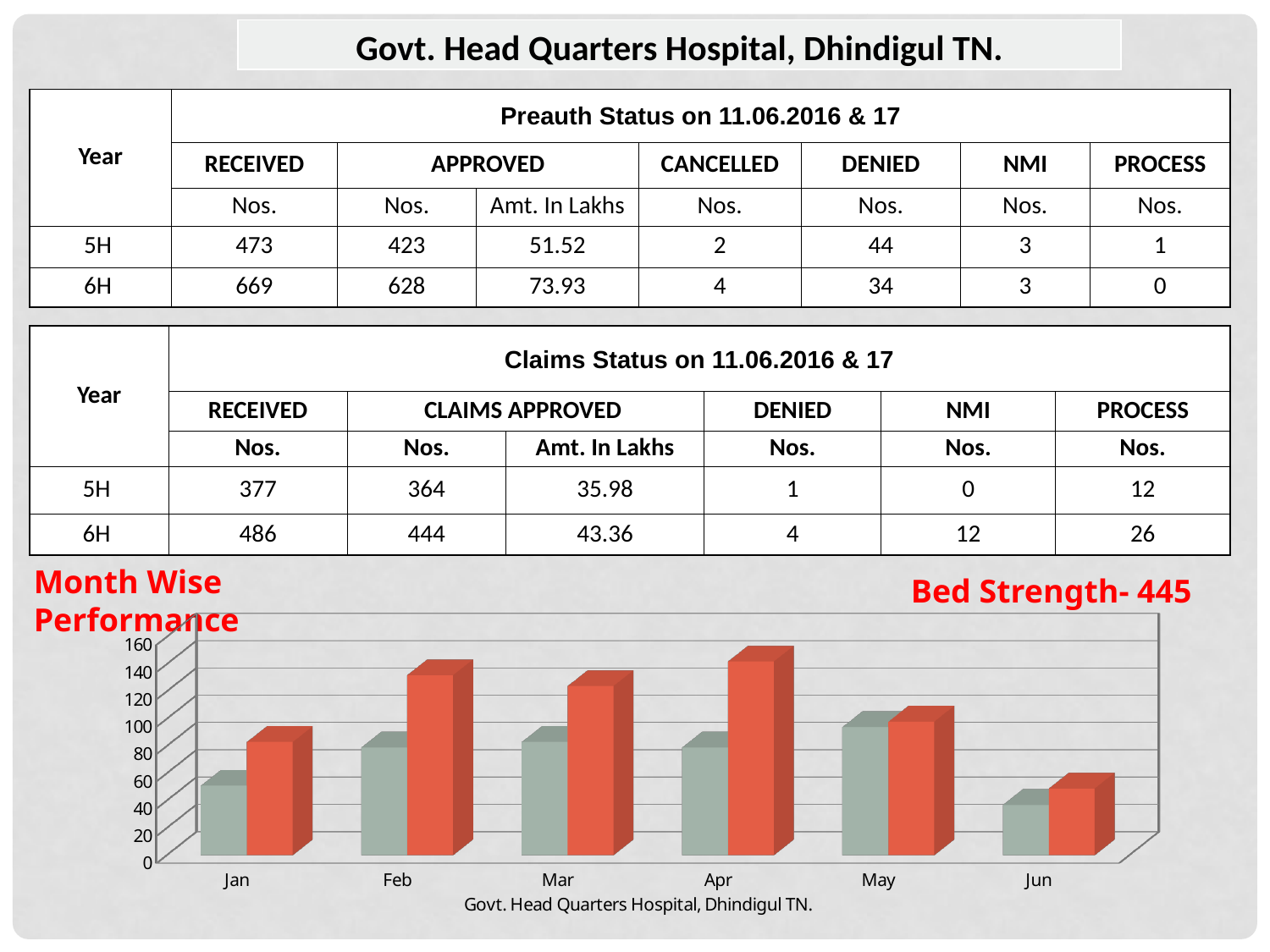
In the Month Wise Performance chart, which month has the shortest grey bar? Jun What kind of chart is shown at the bottom of the slide? bar chart In the Month Wise Performance chart, which month has the larger grey bar: Jan or Jun? Jan In the Month Wise Performance chart, which is larger for Feb: the grey bar or the red bar? the red bar In the Month Wise Performance chart, is the grey bar for Jan greater or less than 80? less In the Month Wise Performance chart, is the red bar for Jun greater or less than 80? less In the Month Wise Performance chart, which month has the shortest red bar? Jun What text appears as the title below the Month Wise Performance chart? Govt. Head Quarters Hospital, Dhindigul TN. In the Month Wise Performance chart, which month has the tallest red bar? Apr In the Month Wise Performance chart, is the red bar for Apr greater or less than 120? greater How many months are shown on the x axis of the Month Wise Performance chart? 6